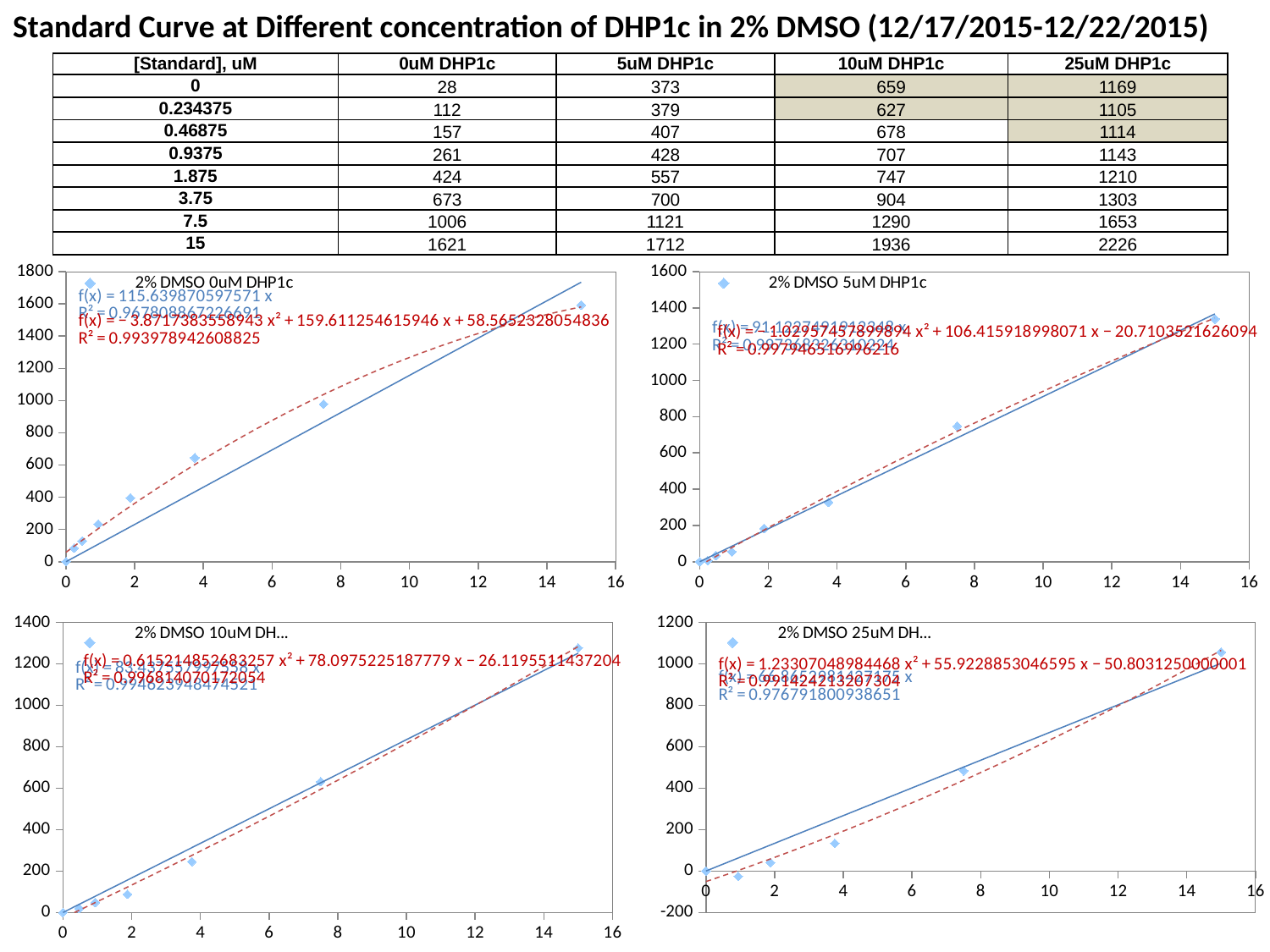
In the top-right chart (2% DMSO 5uM DHP1c), do the plotted values rise or fall as x increases? rise In the top-left chart (2% DMSO 0uM DHP1c), is the value of the data point at x = 7.5 greater or less than 800? greater In the bottom-right chart (2% DMSO 25uM DH...), is the value of the data point at x = 7.5 greater or less than 600? less What is the lowest y-axis tick shown on the bottom-right chart (2% DMSO 25uM DH...)? -200 In the bottom-left chart (2% DMSO 10uM DH...), is the value of the data point at x = 7.5 greater or less than 400? greater In the top-left chart (2% DMSO 0uM DHP1c), at which x value is the highest data point? 15 What kind of chart is the top-left chart titled '2% DMSO 0uM DHP1c'? scatter chart In the top-left chart (2% DMSO 0uM DHP1c), how many data points are plotted? 8 What is the title of the top-right chart? 2% DMSO 5uM DHP1c